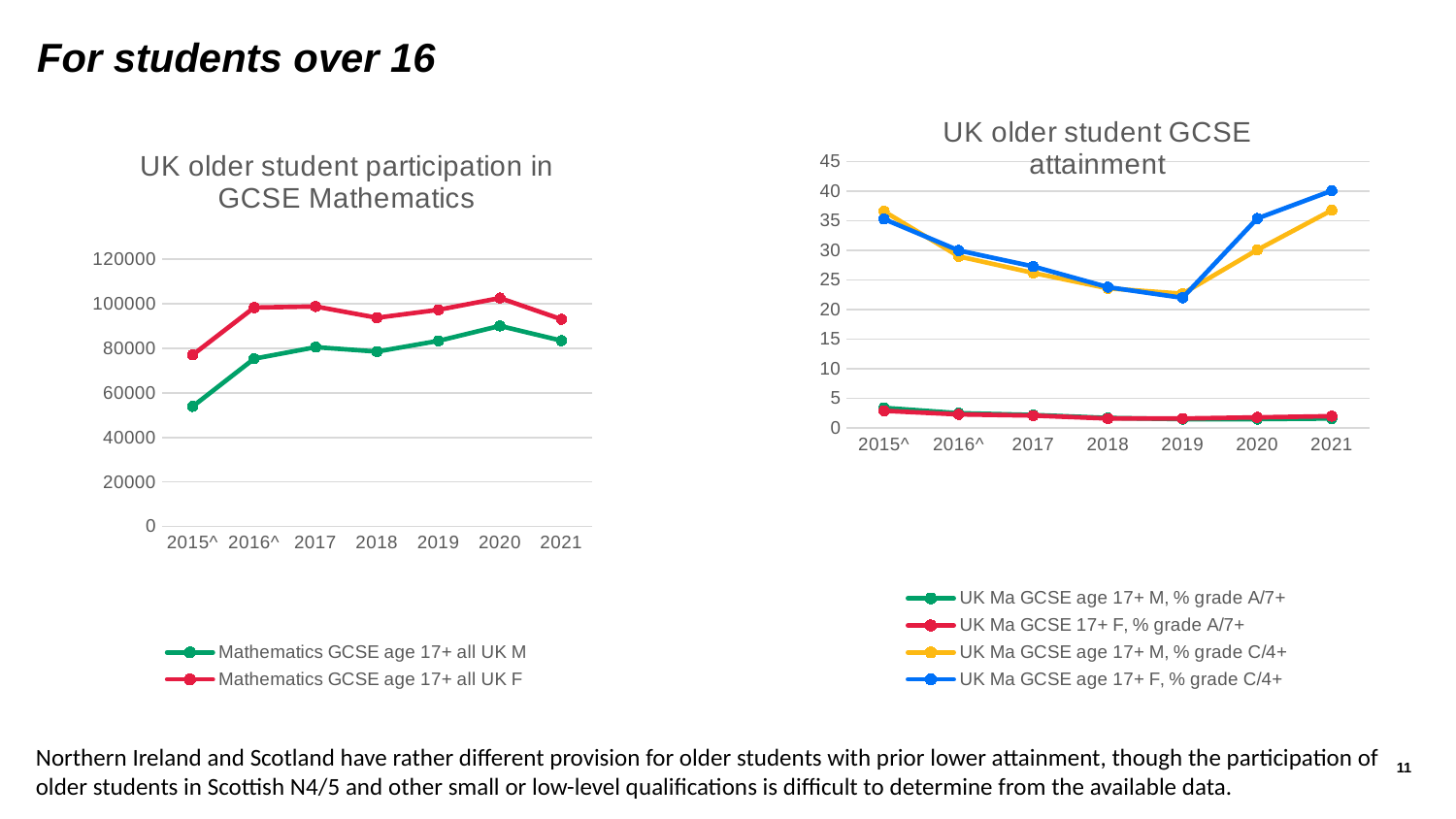
In the 'UK older student GCSE attainment' chart, is the value for 'UK Ma GCSE age 17+ F, % grade C/4+' in 2021 greater or less than 35? greater In the 'UK older student participation in GCSE Mathematics' chart, is the value for 'Mathematics GCSE age 17+ all UK F' in 2020 greater or less than 100000? greater In the 'UK older student participation in GCSE Mathematics' chart, does the 'Mathematics GCSE age 17+ all UK M' series rise or fall from 2015^ to 2017? rise In the 'UK older student participation in GCSE Mathematics' chart, is the value for 'Mathematics GCSE age 17+ all UK M' in 2015^ greater or less than 60000? less How many series does the legend of the 'UK older student GCSE attainment' chart list? 4 What type of chart is the 'UK older student participation in GCSE Mathematics' chart? line chart In the 'UK older student participation in GCSE Mathematics' chart, in which year is the 'Mathematics GCSE age 17+ all UK F' series highest? 2020 In the 'UK older student participation in GCSE Mathematics' chart, which series has the larger value in 2019, 'all UK M' or 'all UK F'? Mathematics GCSE age 17+ all UK F In the 'UK older student GCSE attainment' chart, in which year is the 'UK Ma GCSE age 17+ F, % grade C/4+' series highest? 2021 In the 'UK older student participation in GCSE Mathematics' chart, in which year is the 'Mathematics GCSE age 17+ all UK M' series lowest? 2015^ How many series does the legend of the 'UK older student participation in GCSE Mathematics' chart list? 2 How many years are shown on the x axis of the 'UK older student participation in GCSE Mathematics' chart? 7